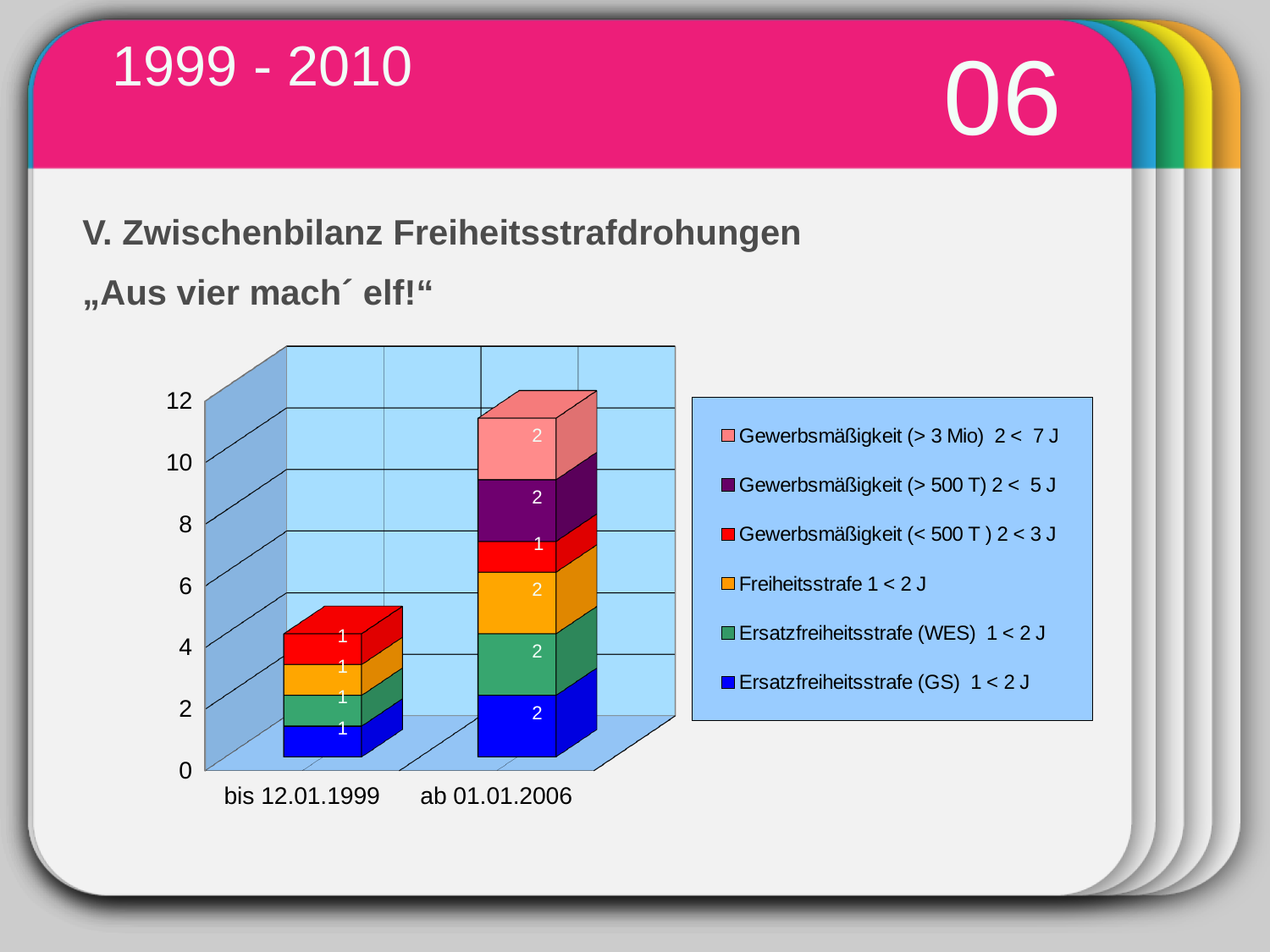
What is the value of the Ersatzfreiheitsstrafe (GS) 1 < 2 J segment for "ab 01.01.2006"? 2 What is the difference between the Ersatzfreiheitsstrafe (WES) 1 < 2 J values for "ab 01.01.2006" and "bis 12.01.1999"? 1 Which legend entry is shown in blue? Ersatzfreiheitsstrafe (GS) 1 < 2 J What is the value of the Freiheitsstrafe 1 < 2 J segment for "bis 12.01.1999"? 1 What is the value of the Gewerbsmäßigkeit (< 500 T ) 2 < 3 J segment for "ab 01.01.2006"? 1 Is the total of the stacked bar for "ab 01.01.2006" greater or less than 10? greater What kind of chart is shown on the slide? stacked bar chart Which category has the higher stacked bar total, "bis 12.01.1999" or "ab 01.01.2006"? ab 01.01.2006 How many series does the chart legend list? 6 What is the total of the stacked bar for "ab 01.01.2006"? 11 How many categories are shown on the x axis of the chart? 2 What is the total of the stacked bar for "bis 12.01.1999"? 4